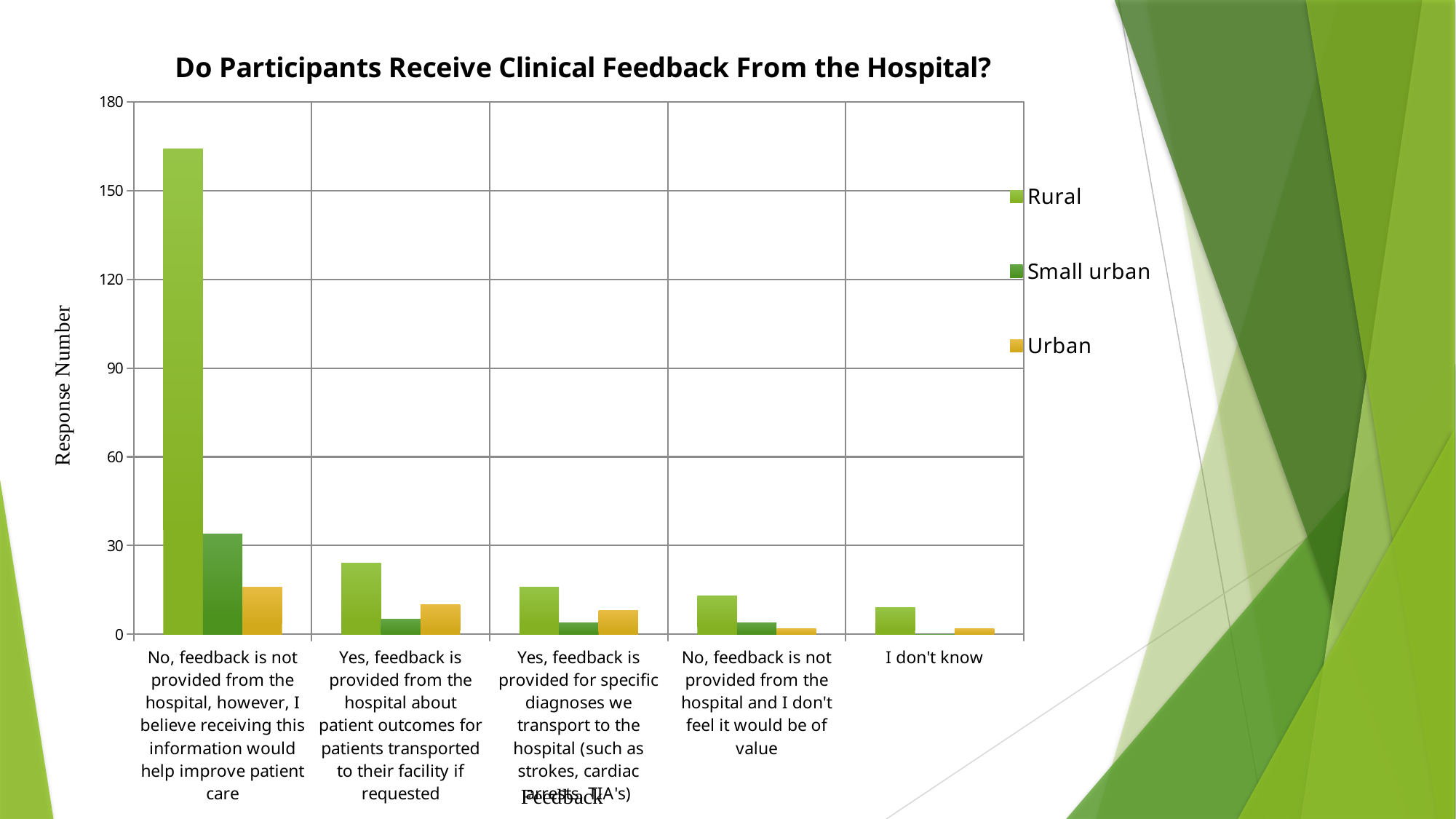
Which response category has the lowest Rural value? I don't know Is the Urban value for "No, feedback is not provided from the hospital, however, I believe receiving this information would help improve patient care" greater or less than 30? less How many response categories are shown on the x axis? 5 Is the Rural value for "I don't know" greater or less than 30? less Do the Rural values rise or fall moving from left to right across the categories? fall Which response category has the highest Rural value? No, feedback is not provided from the hospital, however, I believe receiving this information would help improve patient care For "Yes, feedback is provided from the hospital about patient outcomes for patients transported to their facility if requested", which is larger: the Small urban value or the Urban value? Urban How many series does the legend list? 3 Is the Rural value for "No, feedback is not provided from the hospital, however, I believe receiving this information would help improve patient care" greater or less than 150? greater What is the title of the chart? Do Participants Receive Clinical Feedback From the Hospital? For "No, feedback is not provided from the hospital, however, I believe receiving this information would help improve patient care", which is larger: the Rural value or the Urban value? Rural What kind of chart is shown on the slide? bar chart